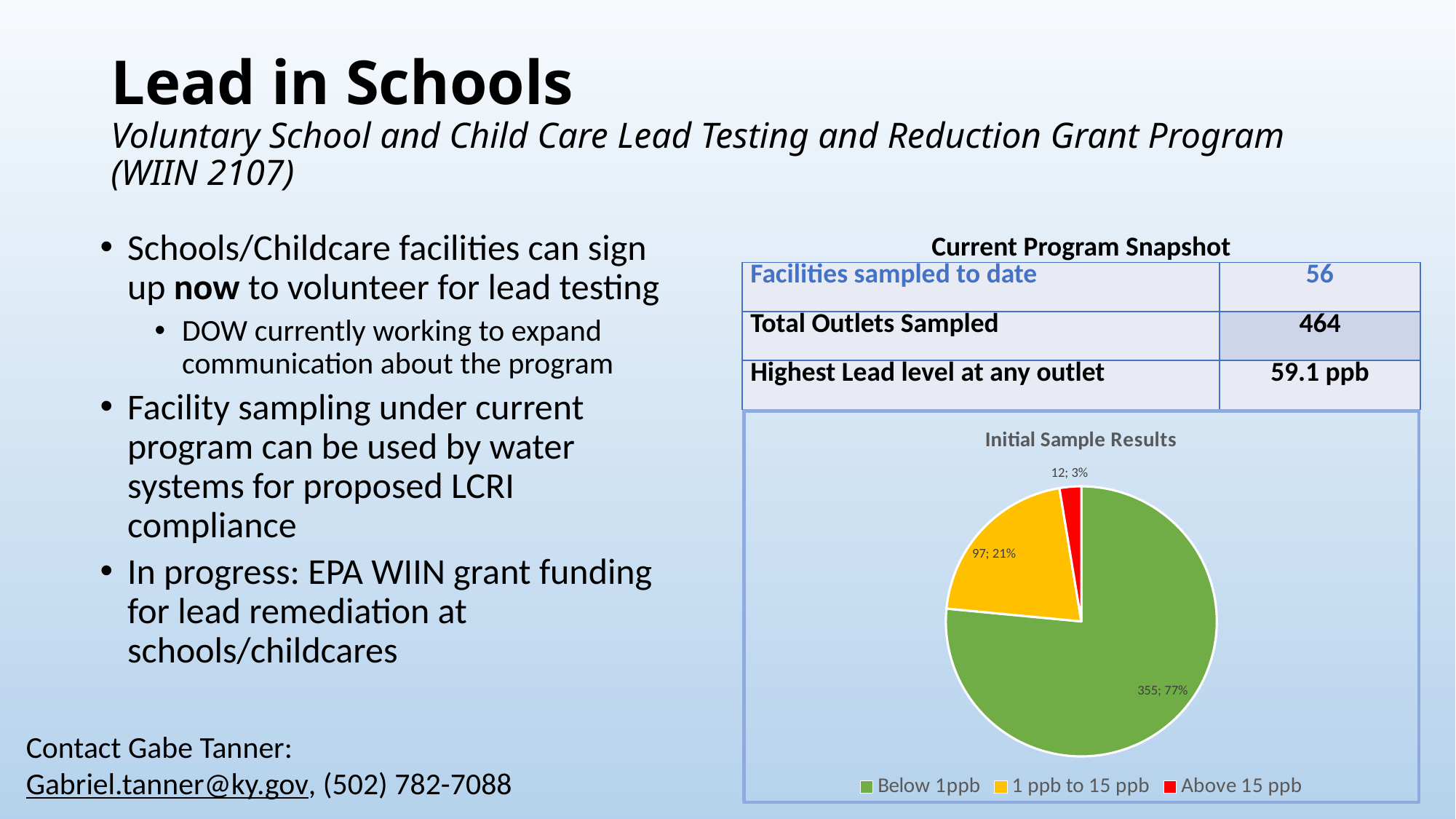
What share of the pie is the Above 15 ppb slice? 3% What type of chart is shown on the slide? pie chart How many samples were Above 15 ppb? 12 How many slices does the pie chart have? 3 Which category has the smallest slice? Above 15 ppb Which category has the largest slice? Below 1ppb How many samples were Below 1ppb? 355 What is the title of the chart? Initial Sample Results How many entries does the chart legend list? 3 What share of the pie is the Below 1ppb slice? 77% How many samples were in the 1 ppb to 15 ppb category? 97 What is the difference in sample count between Below 1ppb and 1 ppb to 15 ppb? 258